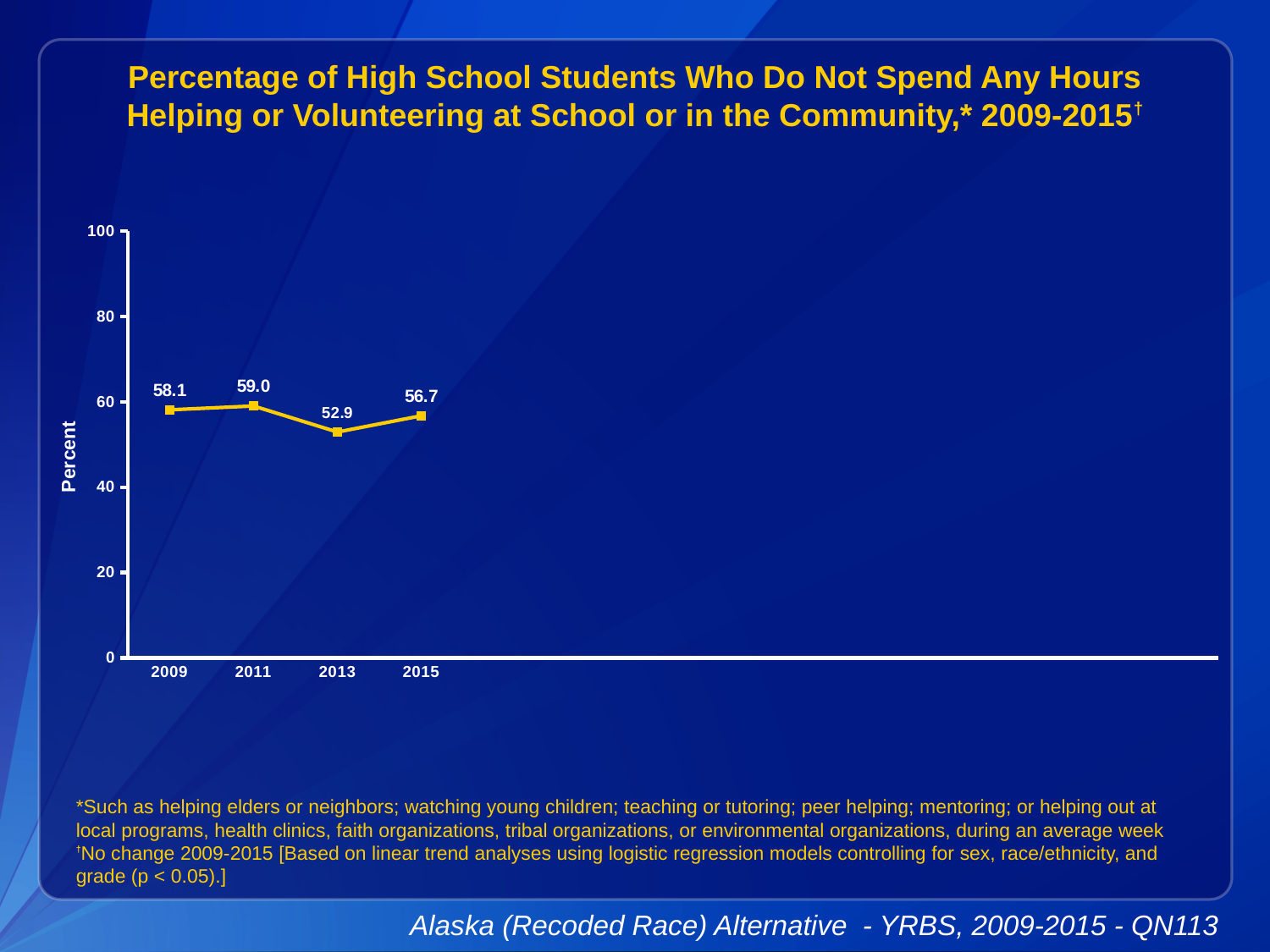
What is the difference between the values for 2011 and 2013? 6.1 What kind of chart is shown? line chart Which year has the lowest value? 2013 What is the value for 2013? 52.9 How many years are plotted on the chart? 4 Which is larger, the value for 2009 or the value for 2015? 2009 What is the label on the y axis? Percent What is the value for 2009? 58.1 Which year has the highest value? 2011 Is the value for 2013 greater or less than 60? less Does the value rise or fall from 2013 to 2015? rise What is the value for 2015? 56.7